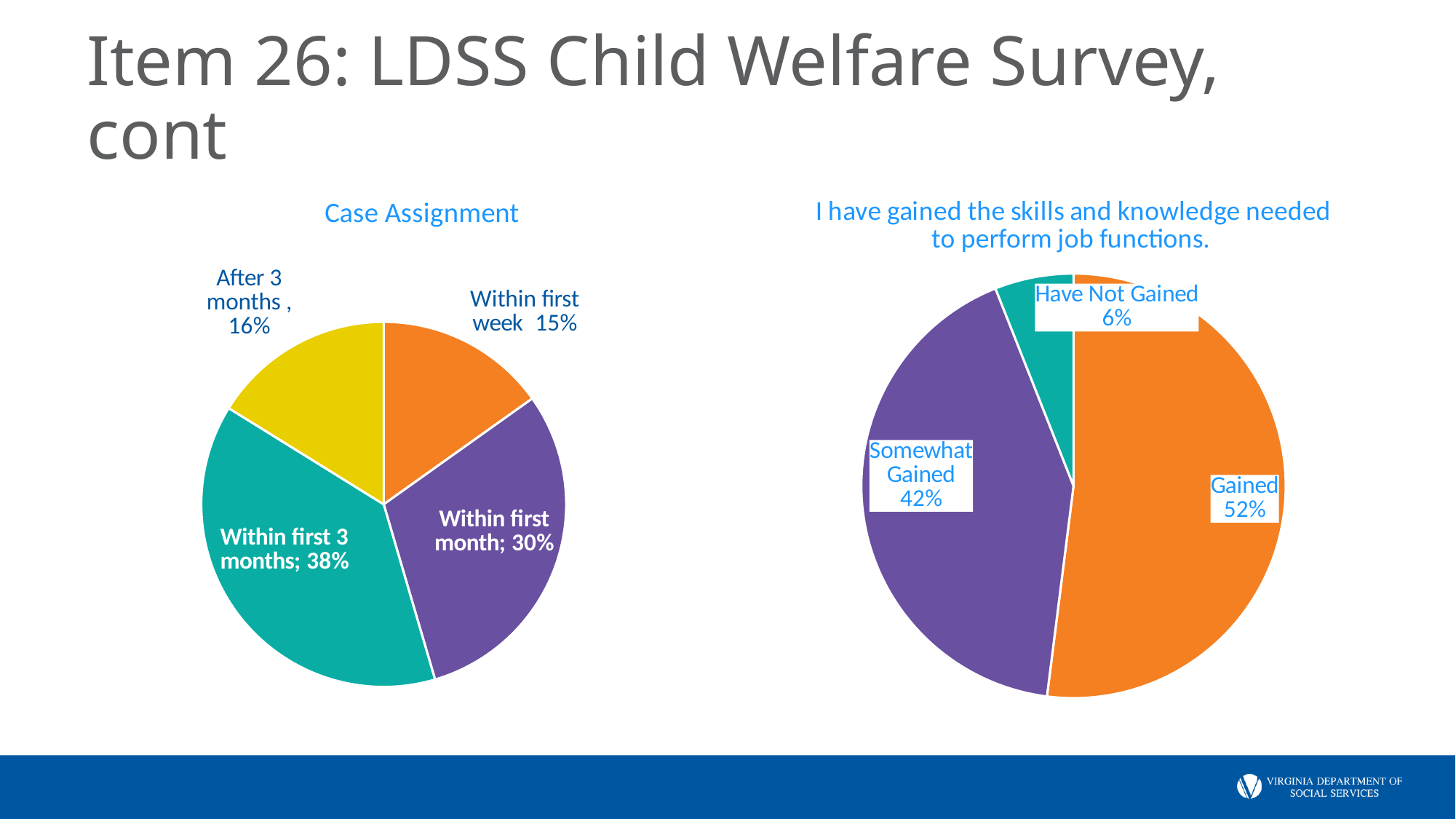
In the Case Assignment chart, what share of cases are assigned within the first 3 months? 38% In the Case Assignment chart, which category has the smallest share? Within first week In the Case Assignment chart, what share of cases are assigned within the first week? 15% In the Case Assignment chart, how many categories are shown? 4 In the chart titled 'I have gained the skills and knowledge needed to perform job functions.', what share of respondents answered 'Gained'? 52% In the Case Assignment chart, which category has the largest share? Within first 3 months In the chart titled 'I have gained the skills and knowledge needed to perform job functions.', what share of respondents answered 'Have Not Gained'? 6% In the Case Assignment chart, what is the difference between the shares for 'Within first 3 months' and 'Within first month'? 8% What kind of chart is the Case Assignment chart? Pie chart In the chart titled 'I have gained the skills and knowledge needed to perform job functions.', which is larger: 'Gained' or 'Somewhat Gained'? Gained In the chart titled 'I have gained the skills and knowledge needed to perform job functions.', what colour is the 'Somewhat Gained' slice? Purple In the chart titled 'I have gained the skills and knowledge needed to perform job functions.', which response has the smallest share? Have Not Gained